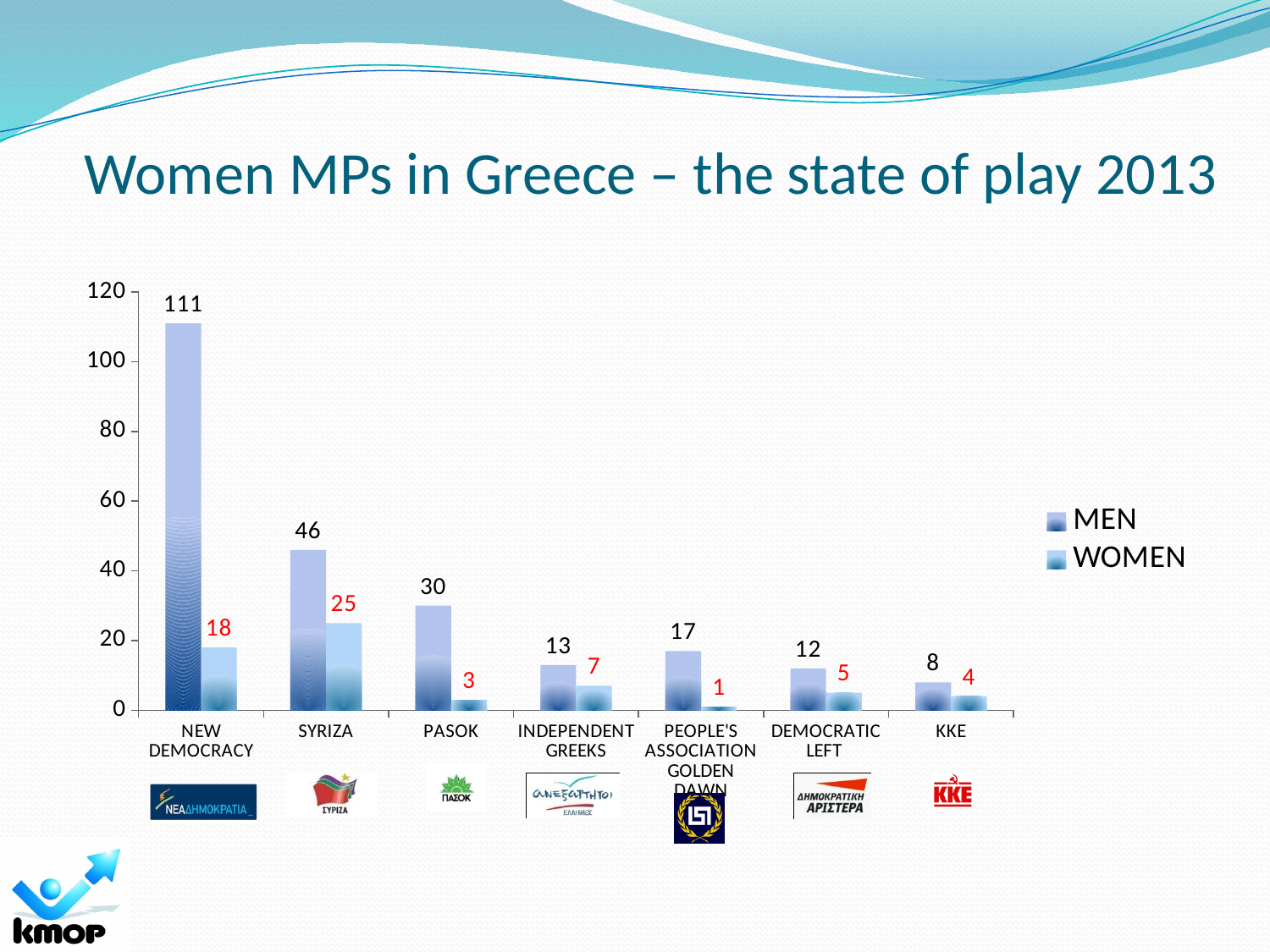
What is the title of the slide? Women MPs in Greece – the state of play 2013 What is the value for WOMEN for PASOK? 3 Which party has the highest number of men MPs? NEW DEMOCRACY How many parties are shown on the x axis? 7 What is the total number of MPs (men plus women) for Democratic Left? 17 Which is larger: the number of women MPs for SYRIZA or for New Democracy? SYRIZA How many series does the legend list? 2 Which party has the lowest number of women MPs? PEOPLE'S ASSOCIATION GOLDEN DAWN What is the difference between men and women MPs for New Democracy? 93 What kind of chart is shown on the slide? bar chart How many men MPs does New Democracy have? 111 How many women MPs does SYRIZA have? 25